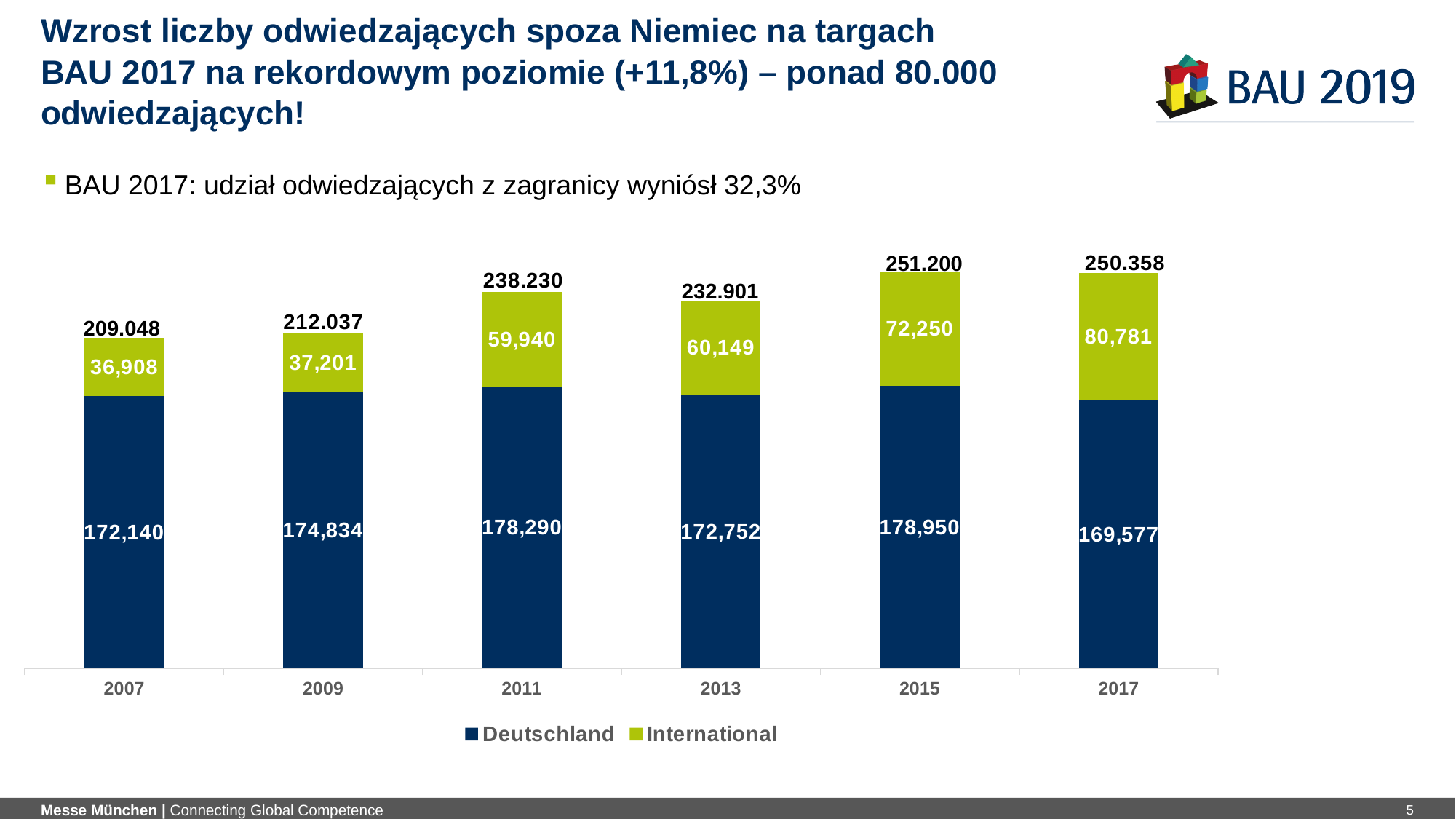
How many years are shown on the x axis? 6 In which year is the International value the lowest? 2007 How many series does the legend list? 2 In which year is the Deutschland value the lowest? 2017 What is the Deutschland value for 2011? 178,290 Which year has the larger International value, 2011 or 2013? 2013 What is the International value for 2017? 80,781 What is the difference between the International values for 2017 and 2015? 8,531 Does the International value generally rise or fall from 2007 to 2017? Rise What is the total number of visitors shown above the bar for 2015? 251.200 What kind of chart is shown on the slide? Stacked bar chart In which year is the International value the highest? 2017